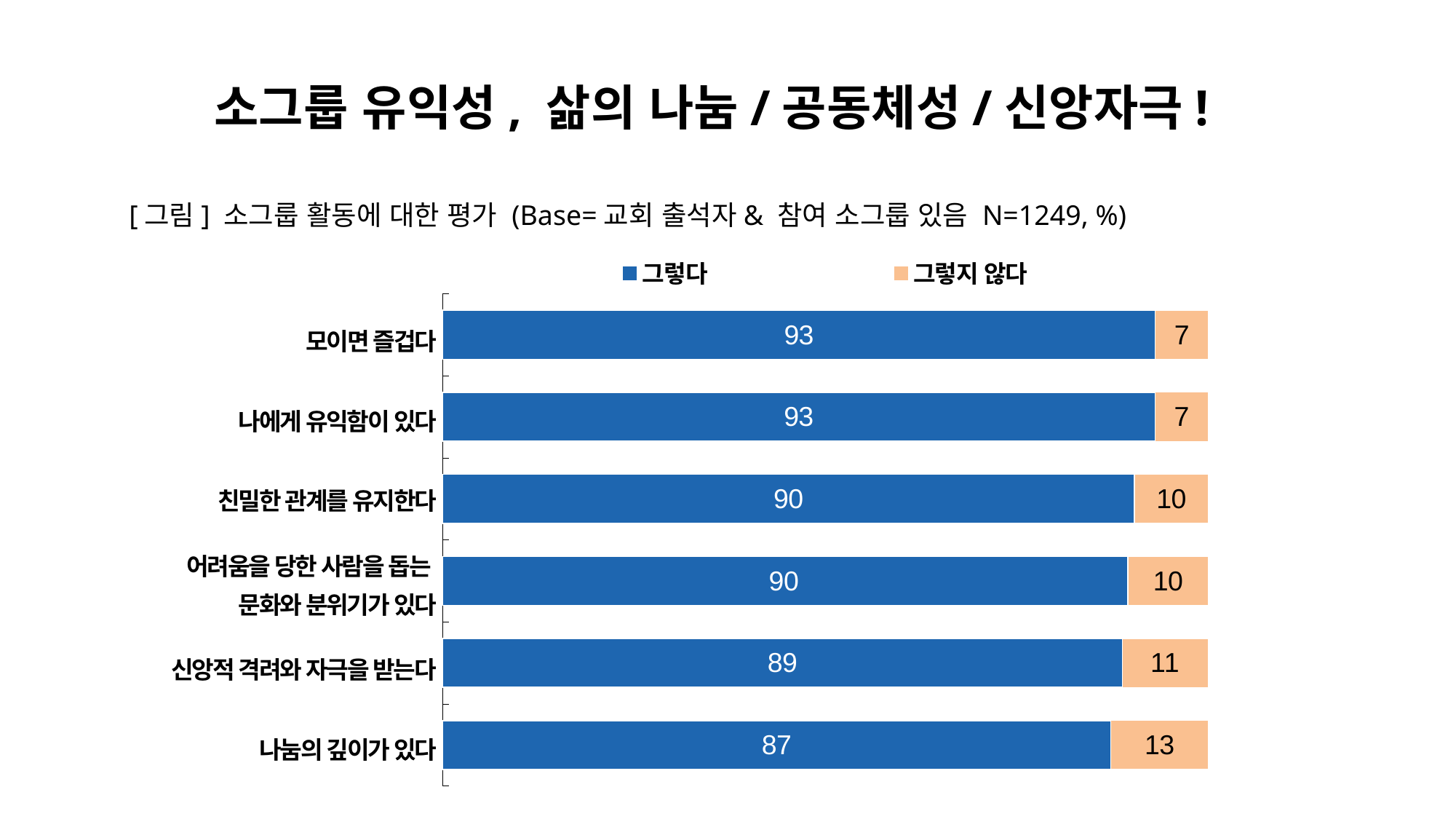
What is the '그렇다' value for '모이면 즐겁다'? 93 How many categories are shown in the chart? 6 What kind of chart is shown on the slide? Stacked bar chart Which category has the lowest '그렇다' value? 나눔의 깊이가 있다 How many series does the legend list? 2 What is the '그렇지 않다' value for '나눔의 깊이가 있다'? 13 What is the '그렇다' value for '신앙적 격려와 자극을 받는다'? 89 What is the '그렇지 않다' value for '친밀한 관계를 유지한다'? 10 What is the difference between the '그렇다' values for '모이면 즐겁다' and '나눔의 깊이가 있다'? 6 Which is larger, the '그렇다' value for '친밀한 관계를 유지한다' or for '신앙적 격려와 자극을 받는다'? 친밀한 관계를 유지한다 What is the total of the stacked bar for '어려움을 당한 사람을 돕는 문화와 분위기가 있다'? 100 Which category has the highest '그렇지 않다' value? 나눔의 깊이가 있다